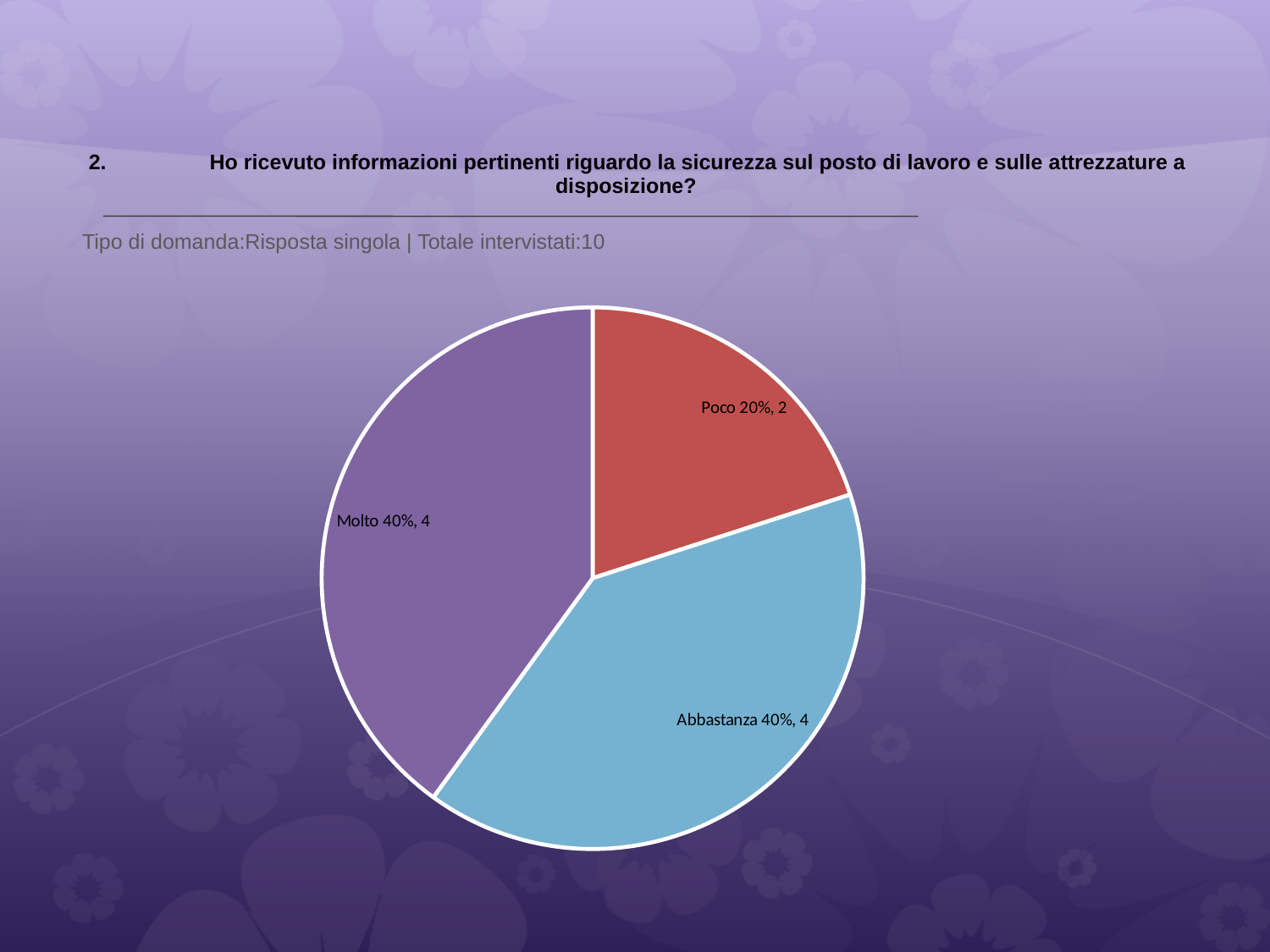
Which category has the smallest slice? Poco What is the total number of respondents across all slices? 10 Which is larger, the 'Abbastanza' slice or the 'Poco' slice? Abbastanza What colour is the 'Molto' slice? purple How many respondents answered 'Poco'? 2 How many respondents answered 'Abbastanza'? 4 What percentage share does the 'Molto' slice have? 40% What is the difference in respondent count between 'Molto' and 'Poco'? 2 What percentage share does the 'Poco' slice have? 20% How many slices does the pie chart have? 3 What kind of chart is shown on the slide? pie chart What colour is the 'Poco' slice? red